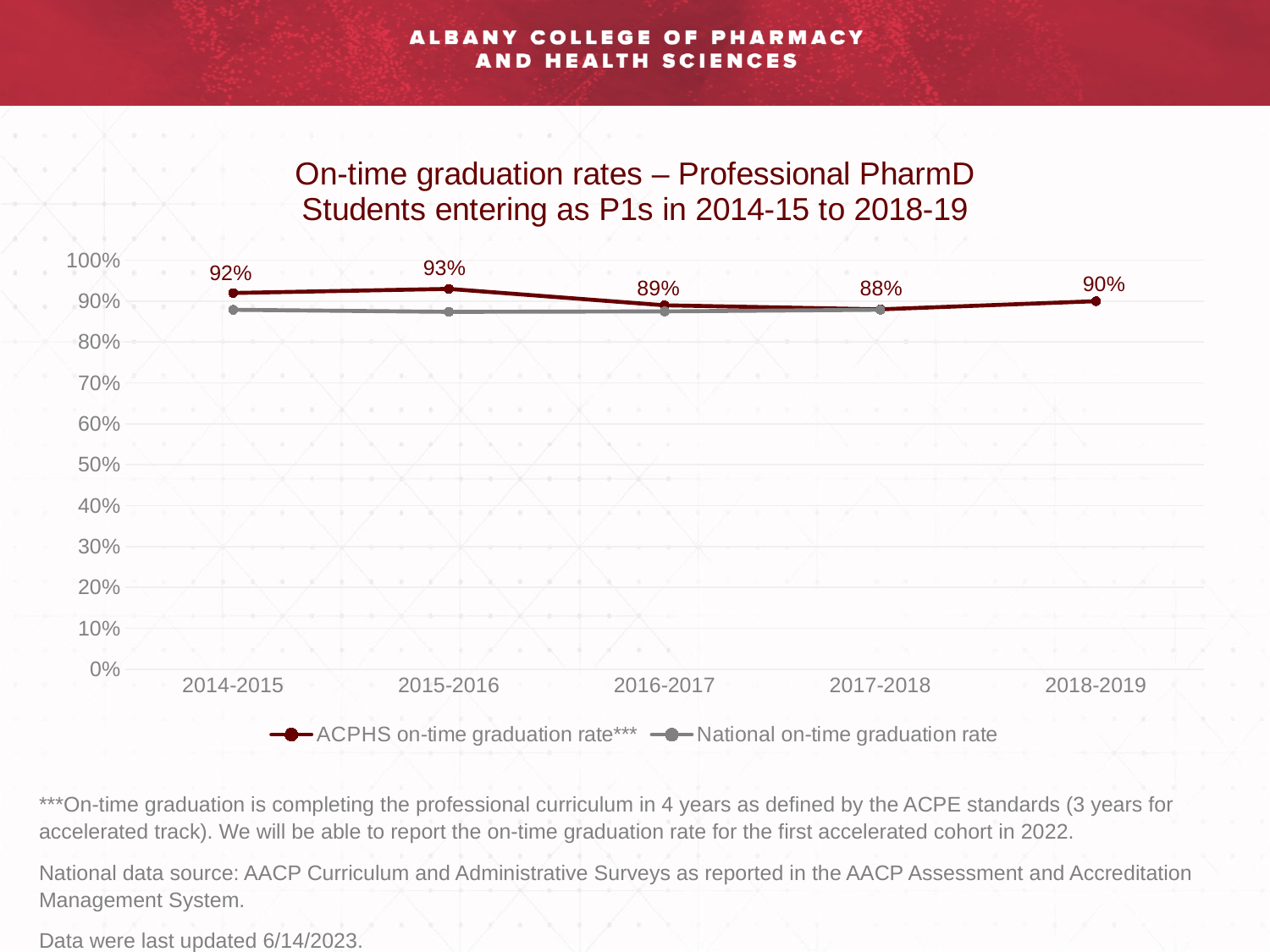
Is the National on-time graduation rate for 2015-2016 greater or less than 80%? greater What is the difference between the ACPHS on-time graduation rate in 2015-2016 and in 2017-2018? 5% In which year is the ACPHS on-time graduation rate lowest? 2017-2018 What is the ACPHS on-time graduation rate for 2017-2018? 88% What is the ACPHS on-time graduation rate for 2015-2016? 93% How many entering cohort years are shown on the x axis? 5 How many series does the legend list? 2 What kind of chart is shown on the slide? line chart What is the ACPHS on-time graduation rate for 2018-2019? 90% Which series is drawn in gray? National on-time graduation rate Which is larger, the ACPHS on-time graduation rate in 2014-2015 or in 2016-2017? 2014-2015 In which year is the ACPHS on-time graduation rate highest? 2015-2016